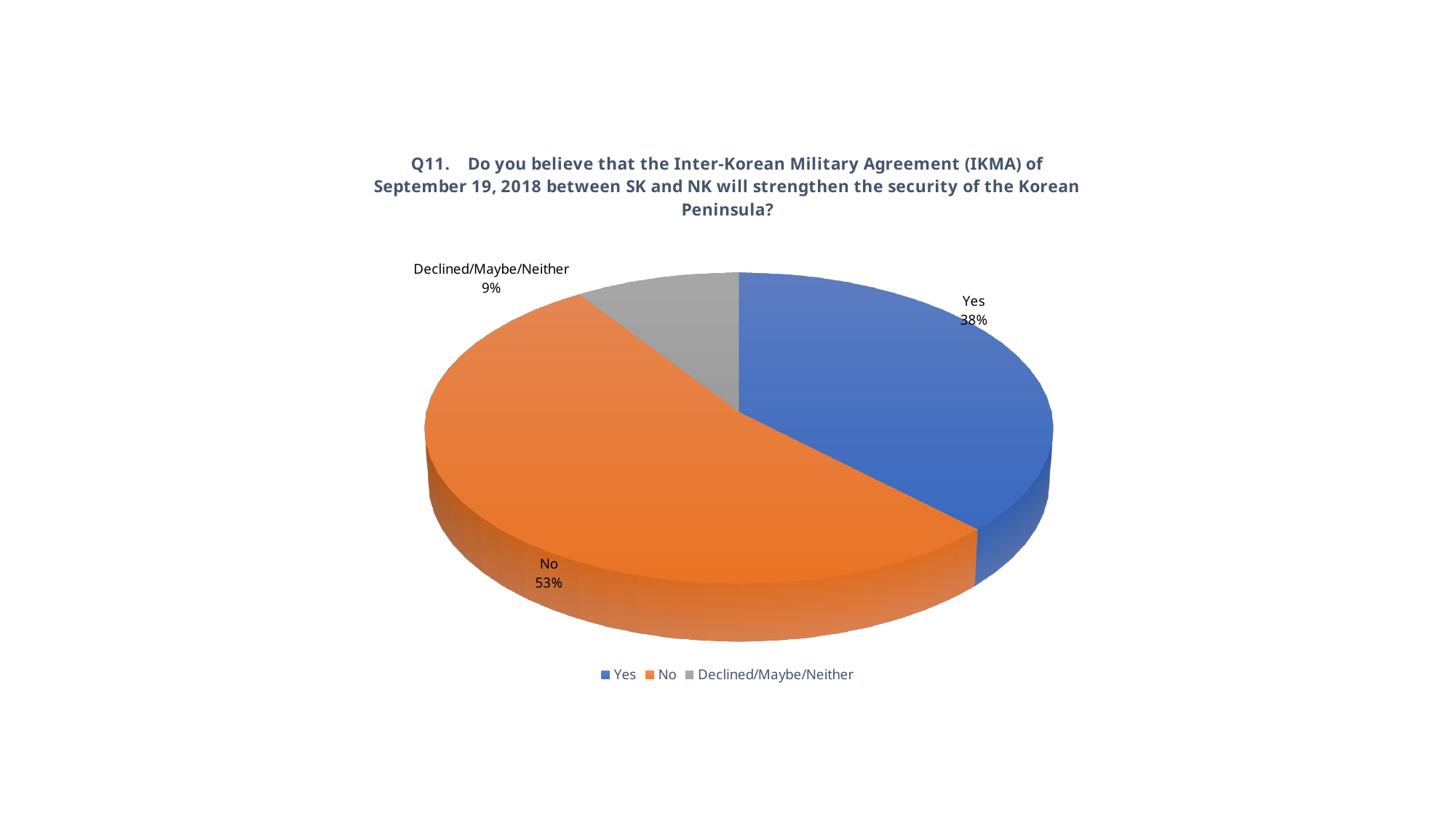
Which is larger, the share for Yes or the share for No? No What share of respondents answered No? 53% What colour is the No slice? Orange What is the difference in percentage points between the No and Yes shares? 15 What share of respondents fall under Declined/Maybe/Neither? 9% How many entries does the legend list? 3 How many slices does the pie chart have? 3 What kind of chart is shown on the slide? Pie chart What share of respondents answered Yes? 38% Which response has the largest share of the pie? No What is the combined share of Yes and Declined/Maybe/Neither? 47% Which response has the smallest share of the pie? Declined/Maybe/Neither